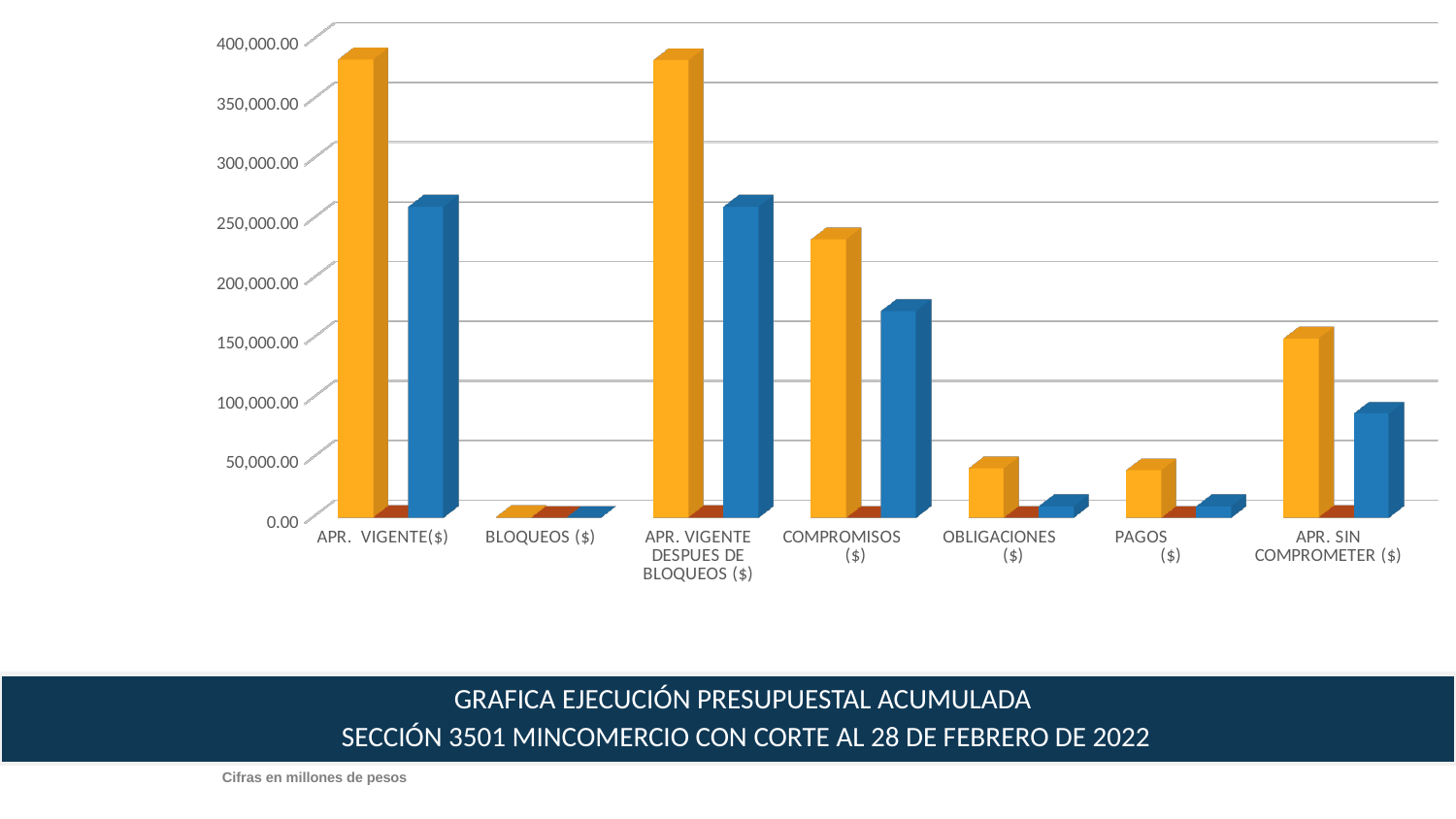
Which blue bar is taller: APR. SIN COMPROMETER ($) or PAGOS ($)? APR. SIN COMPROMETER ($) Is the orange bar for APR. SIN COMPROMETER ($) greater or less than 100,000.00? greater Which category has the lowest bars in the chart? BLOQUEOS ($) How many categories are shown on the x axis of the chart? 7 Is the blue bar for COMPROMISOS ($) greater or less than 200,000.00? less According to the note below the chart, in what units are the figures expressed? Millones de pesos Is the orange bar for APR. VIGENTE($) greater or less than 350,000.00? greater What kind of chart is shown on the slide? Bar chart Which orange bar is taller: COMPROMISOS ($) or OBLIGACIONES ($)? COMPROMISOS ($)